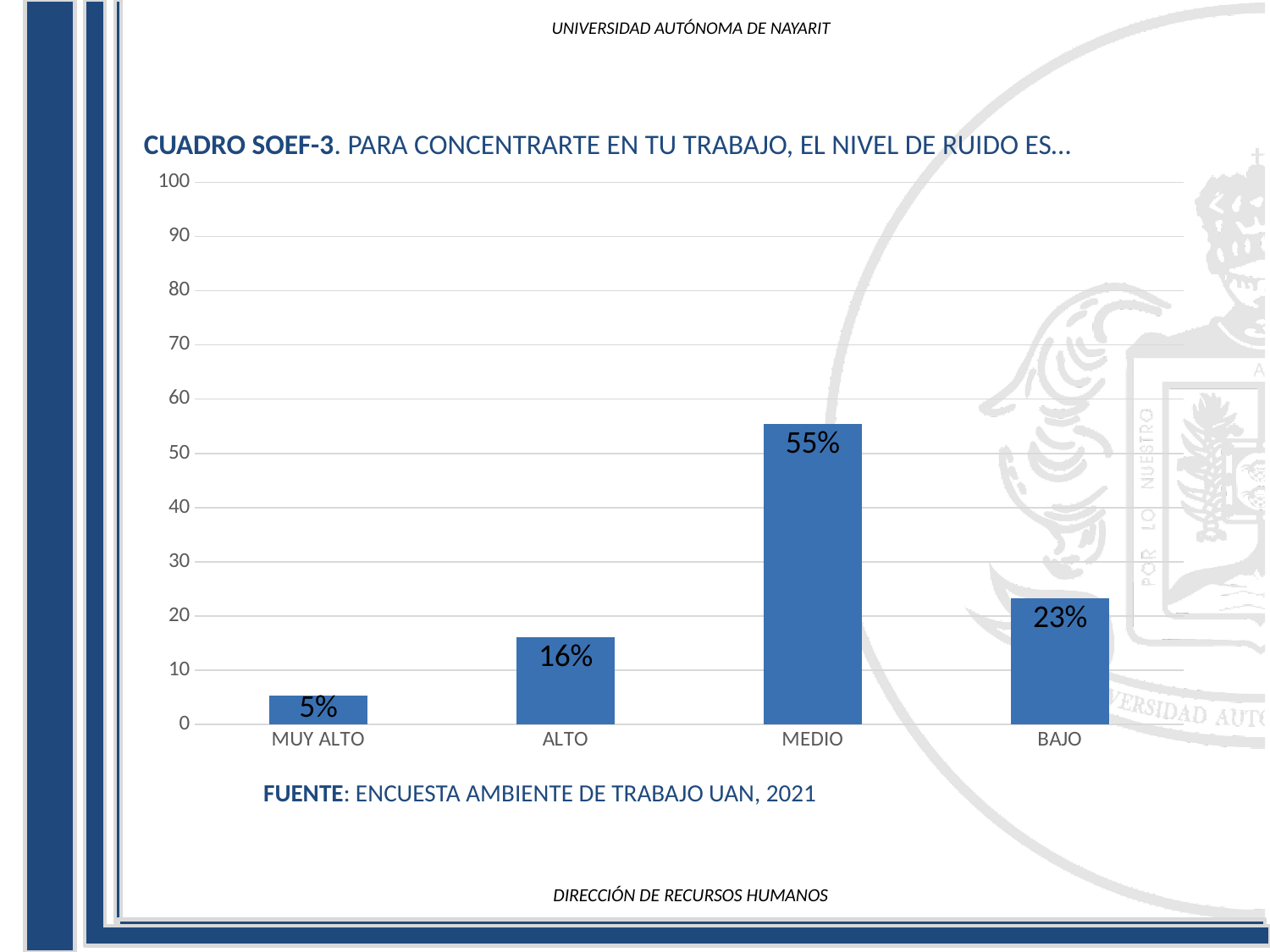
Which is larger, the value for ALTO or the value for BAJO? BAJO Which category has the highest value? MEDIO How many categories are shown on the x axis? 4 Is the value for MEDIO greater or less than 50? greater Which category has the lowest value? MUY ALTO What kind of chart is shown on the slide? bar chart What is the value for BAJO? 23% What is the difference between the values for MEDIO and BAJO? 32% What is the value for MUY ALTO? 5% What source is cited below the chart? ENCUESTA AMBIENTE DE TRABAJO UAN, 2021 What is the value for MEDIO? 55% What is the value for ALTO? 16%